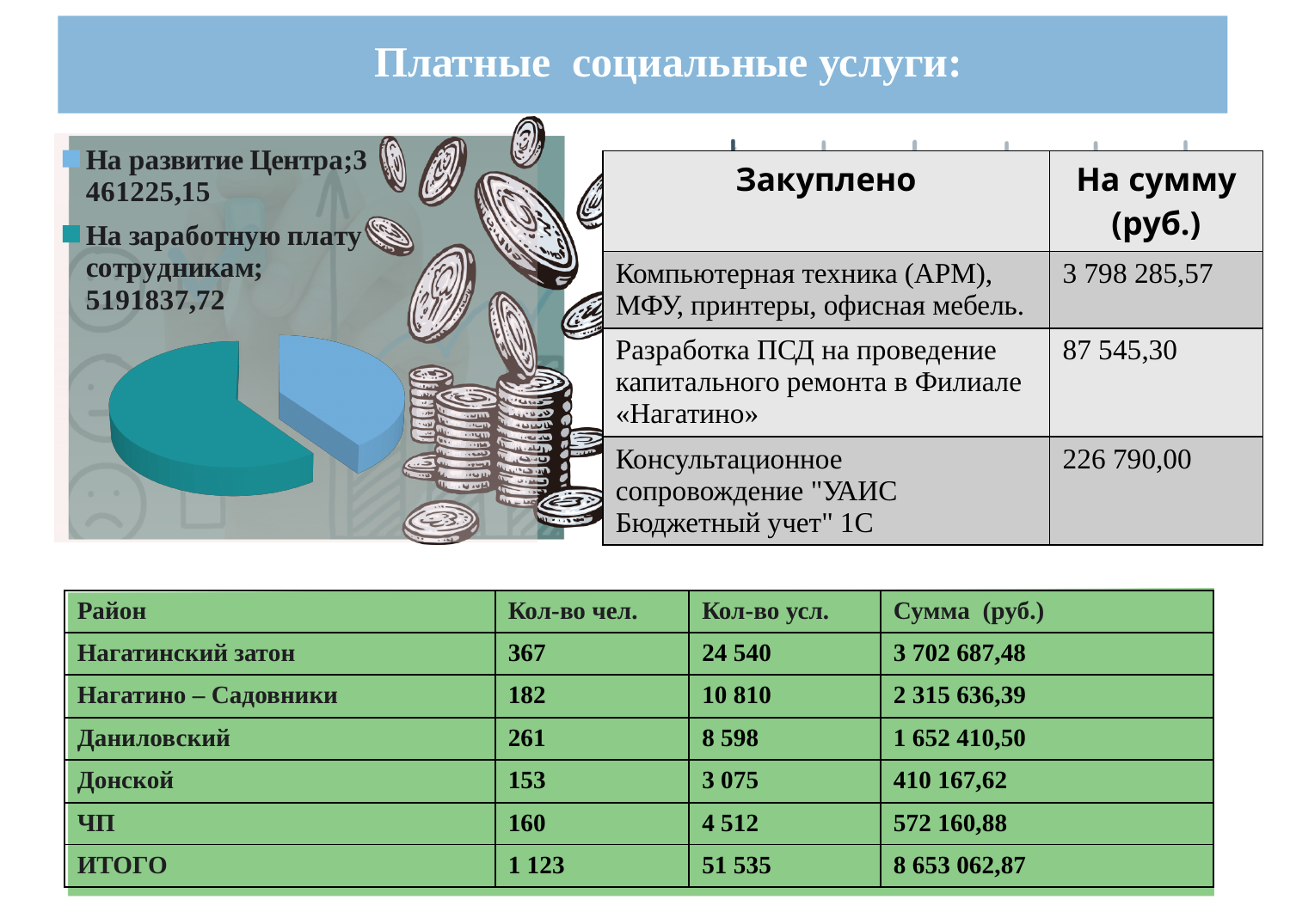
What share of the pie chart does "На развитие Центра" represent? 40% In the pie chart, what is the value for "На развитие Центра"? 3 461225,15 In the pie chart, which is larger: "На развитие Центра" or "На заработную плату сотрудникам"? На заработную плату сотрудникам What colour is the "На заработную плату сотрудникам" slice in the pie chart? teal In the pie chart, what is the value for "На заработную плату сотрудникам"? 5191837,72 What kind of chart is shown on the left of the slide? pie chart Which slice of the pie chart is the largest? На заработную плату сотрудникам How many entries does the pie chart legend list? 2 What is the total of the two values shown in the pie chart? 8653062,87 What is the difference between the two values in the pie chart? 1730612,57 How many slices does the pie chart have? 2 Which slice of the pie chart is the smallest? На развитие Центра